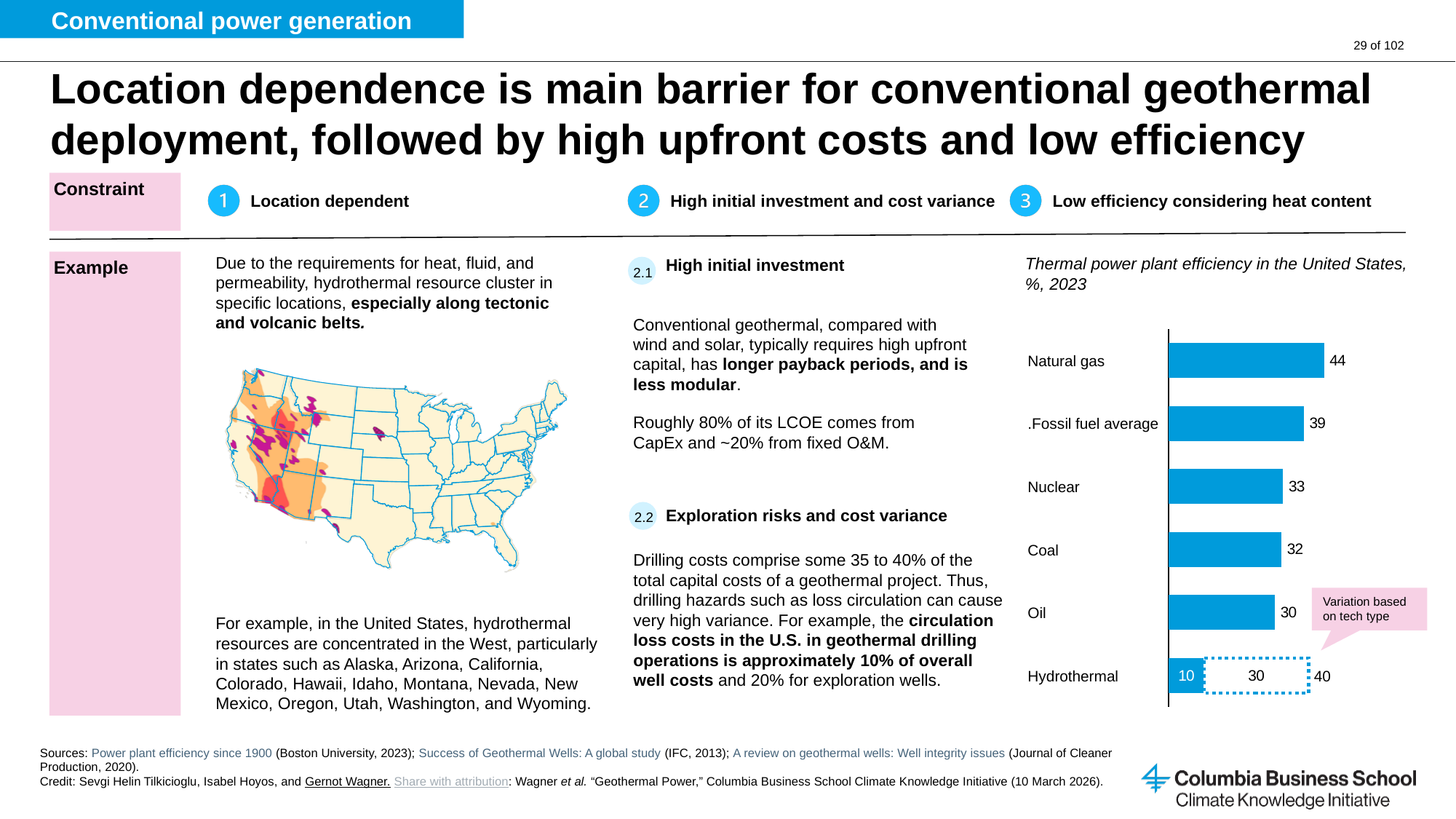
What type of chart is used to show thermal power plant efficiency? Bar chart What is the thermal power plant efficiency shown for Natural gas? 44 Which has a higher efficiency value, Nuclear or Oil? Nuclear Which category has the lowest solid-bar efficiency in the chart? Hydrothermal What is the title of the chart on the right of the slide? Thermal power plant efficiency in the United States, %, 2023 What efficiency value is shown for Coal? 32 How many categories are plotted in the chart? 6 What is the value of the solid bar for Hydrothermal? 10 What efficiency value is shown for Oil? 30 Which category has the highest efficiency in the chart? Natural gas What efficiency value is shown for Nuclear in the chart? 33 What is the difference between the efficiency of Natural gas and the Fossil fuel average? 5